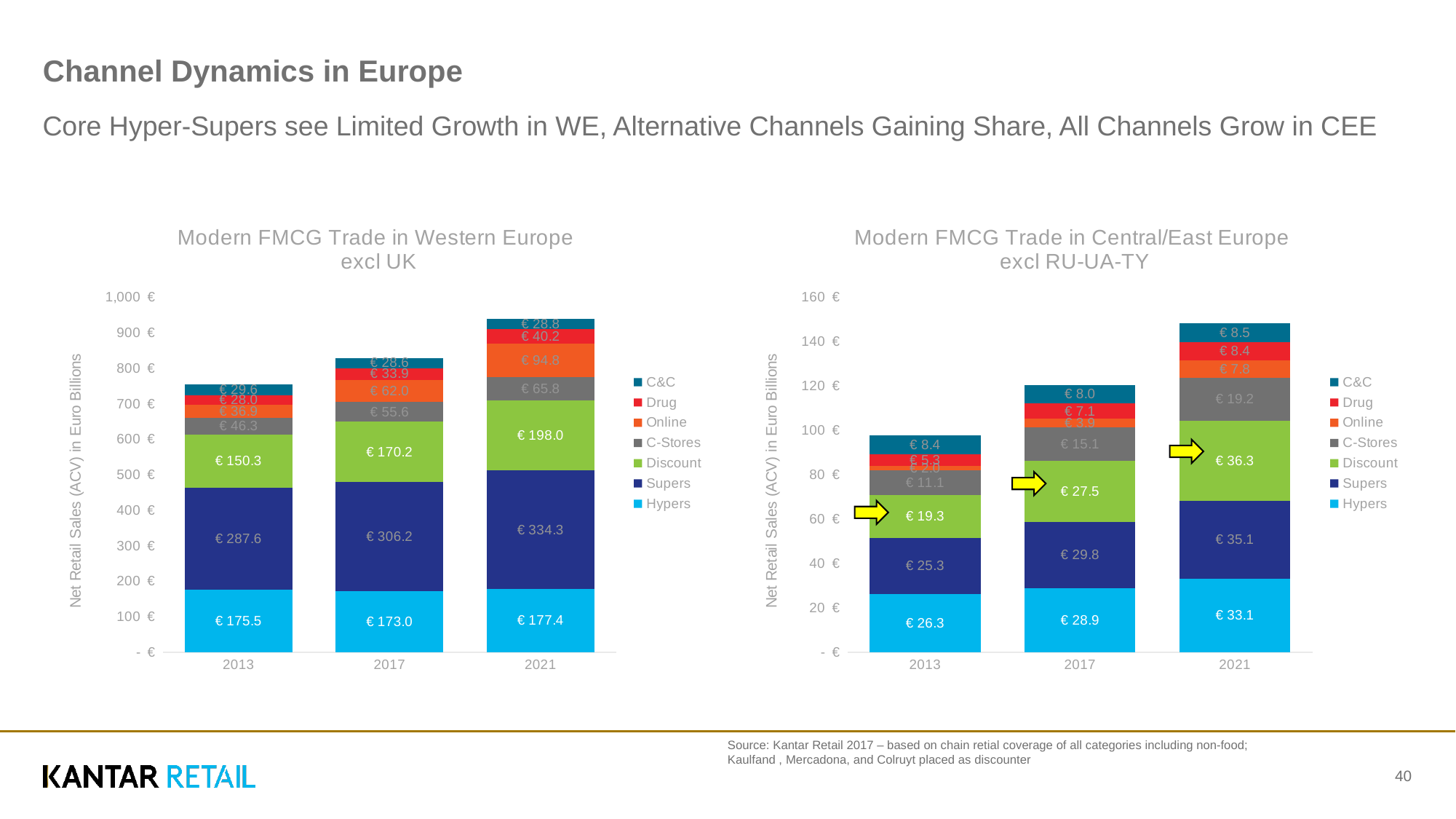
In the Modern FMCG Trade in Western Europe excl UK chart, is the total height of the 2017 bar greater or less than 800 €? greater In the Modern FMCG Trade in Central/East Europe excl RU-UA-TY chart, what is the value for Discount in 2017? € 27.5 In the Modern FMCG Trade in Western Europe excl UK chart, by how much does the Discount value in 2021 exceed the Discount value in 2013? € 47.7 In the Modern FMCG Trade in Central/East Europe excl RU-UA-TY chart, what is the total of the 2021 stacked bar? € 148.4 What kind of chart is the Modern FMCG Trade in Central/East Europe excl RU-UA-TY chart? Stacked bar chart In the Modern FMCG Trade in Western Europe excl UK chart, does the Online value rise or fall from 2013 to 2021? Rise In the Modern FMCG Trade in Central/East Europe excl RU-UA-TY chart, which is larger in 2021: Discount or Supers? Discount How many years are shown on the x axis of the Modern FMCG Trade in Western Europe excl UK chart? 3 How many series does the legend of the Modern FMCG Trade in Western Europe excl UK chart list? 7 In the Modern FMCG Trade in Central/East Europe excl RU-UA-TY chart, what is the value for Hypers in 2013? € 26.3 In the Modern FMCG Trade in Western Europe excl UK chart, what is the value for Supers in 2021? € 334.3 In the Modern FMCG Trade in Western Europe excl UK chart, which channel has the largest segment in the 2021 bar? Supers